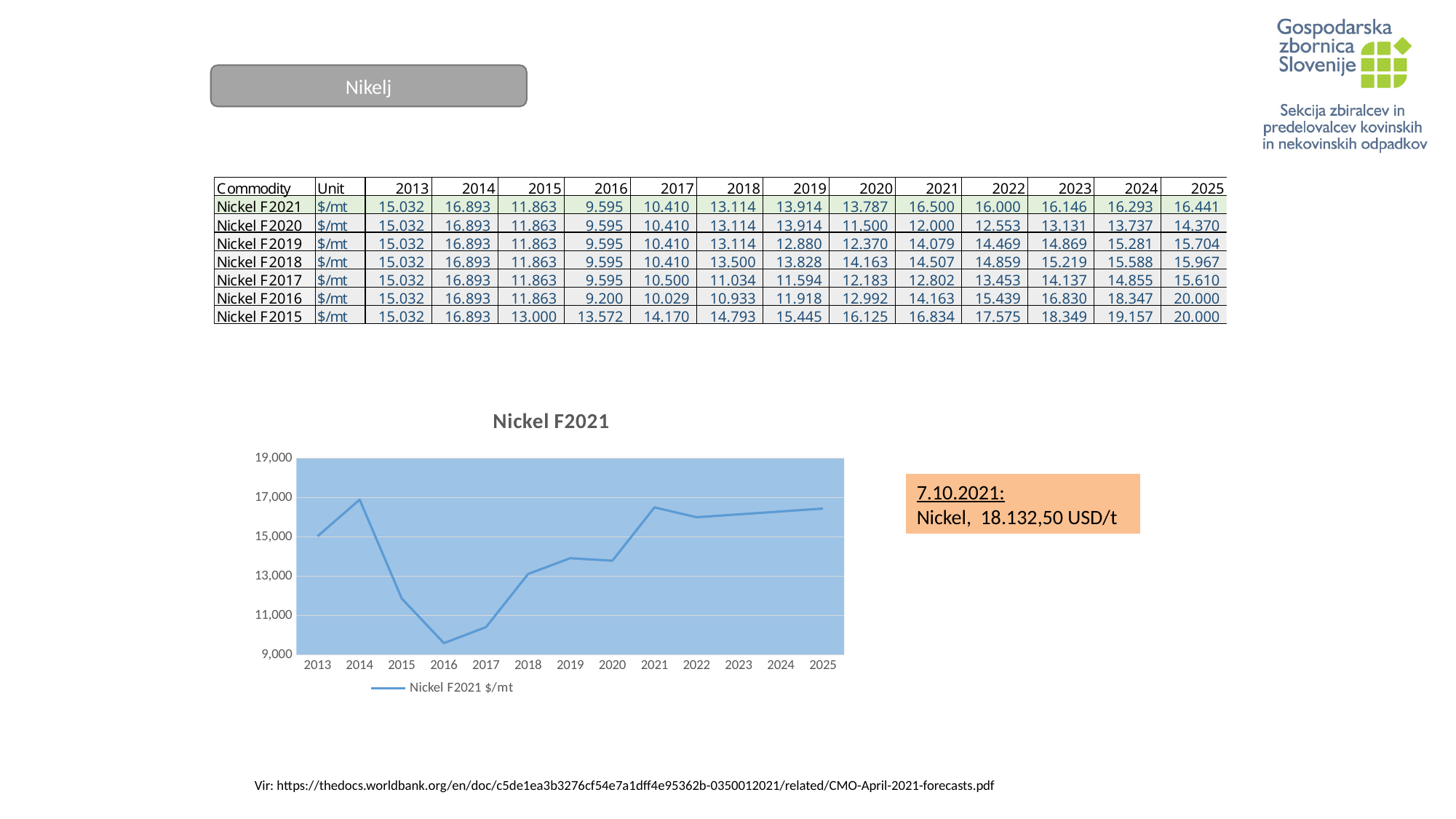
In which year does the Nickel F2021 line reach its highest value? 2014 What kind of chart is shown under the title "Nickel F2021"? line chart Is the Nickel F2021 value for 2021 greater or less than 15,000? greater Which year has the larger Nickel F2021 value, 2013 or 2015? 2013 In which year does the Nickel F2021 line reach its lowest value? 2016 How many series does the legend of the Nickel F2021 chart list? 1 Does the Nickel F2021 line rise or fall between 2014 and 2016? fall Is the Nickel F2021 value for 2016 greater or less than 11,000? less Is the Nickel F2021 value for 2017 greater or less than 11,000? less How many years are plotted on the x axis of the Nickel F2021 chart? 13 What is the legend entry shown below the Nickel F2021 chart? Nickel F2021 $/mt